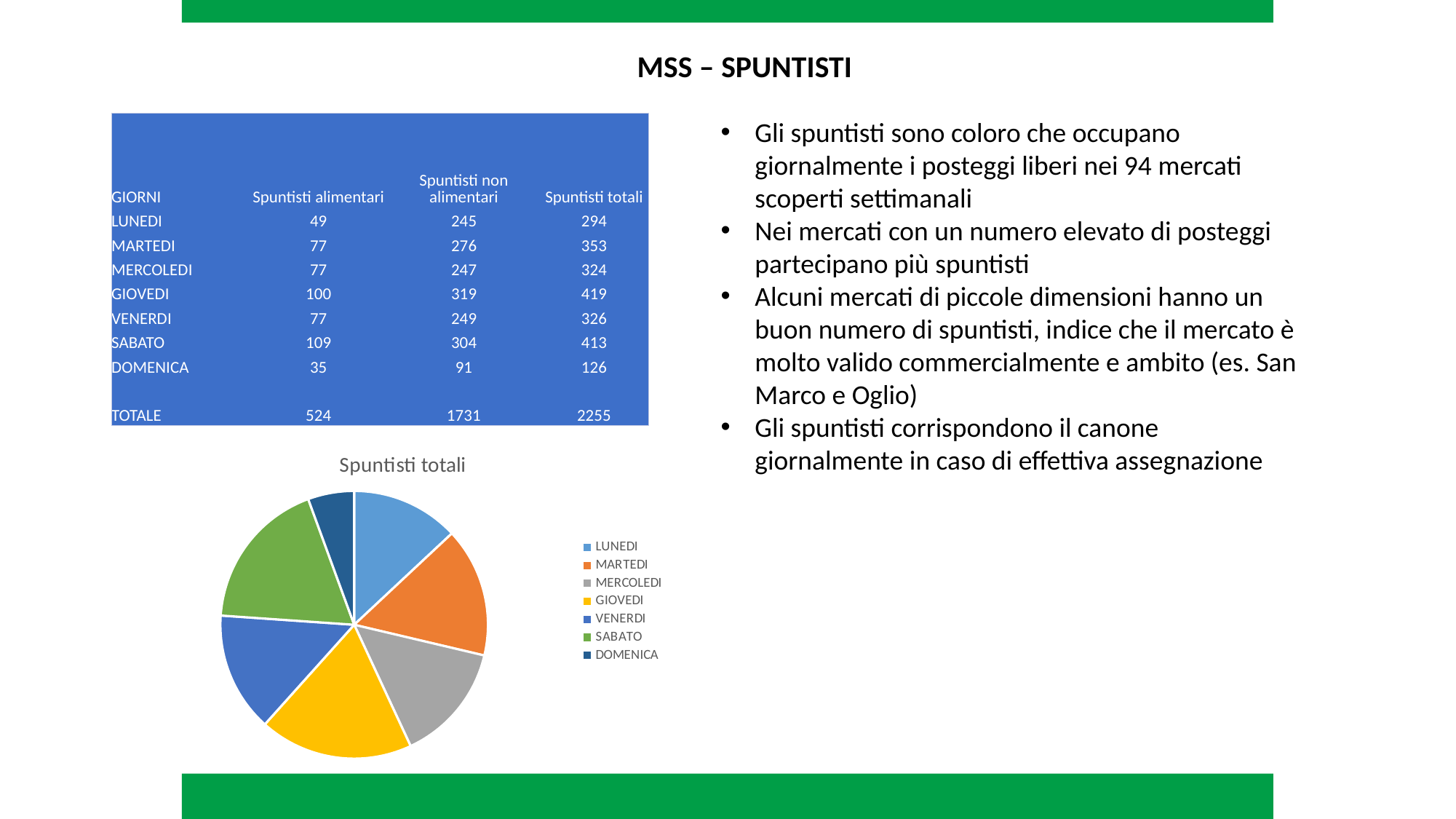
What colour is the SABATO slice in the pie chart? green What kind of chart is shown on the slide? pie chart What is the Spuntisti totali value for GIOVEDI shown on the slide? 419 Which day has the smallest slice in the pie chart? DOMENICA How many slices does the pie chart have? 7 Which slice is larger in the pie chart, DOMENICA or LUNEDI? LUNEDI What is the Spuntisti totali value for DOMENICA shown on the slide? 126 What is the total of all Spuntisti totali values across the seven days? 2255 Which slice is larger in the pie chart, LUNEDI or MARTEDI? MARTEDI What is the difference between the Spuntisti totali values for GIOVEDI and DOMENICA? 293 What is the title of the pie chart? Spuntisti totali How many entries does the pie chart's legend list? 7